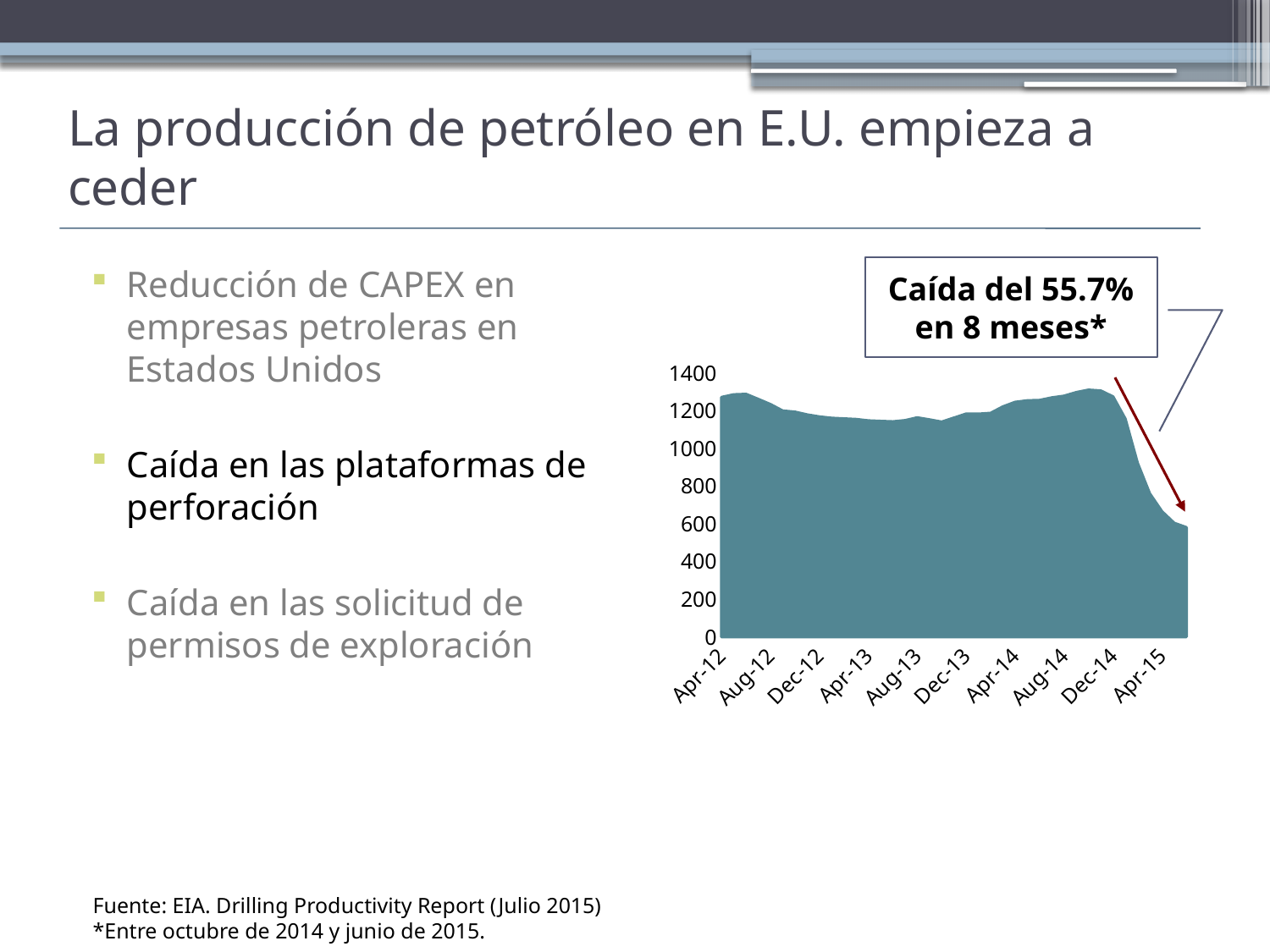
Is the value at Apr-13 greater or less than 1000? greater Does the plotted value rise or fall between Dec-14 and Apr-15? Fall How many date labels are shown on the x axis? 10 What is the highest value shown on the y axis? 1400 Which x-axis label has the lowest plotted value? Apr-15 Which is larger, the value at Apr-12 or the value at Apr-15? Apr-12 Is the value at Apr-15 greater or less than 800? less Is the value at Dec-14 greater or less than 1000? greater What kind of chart is shown on the slide? Area chart What percentage drop does the annotation box above the chart state? 55.7%